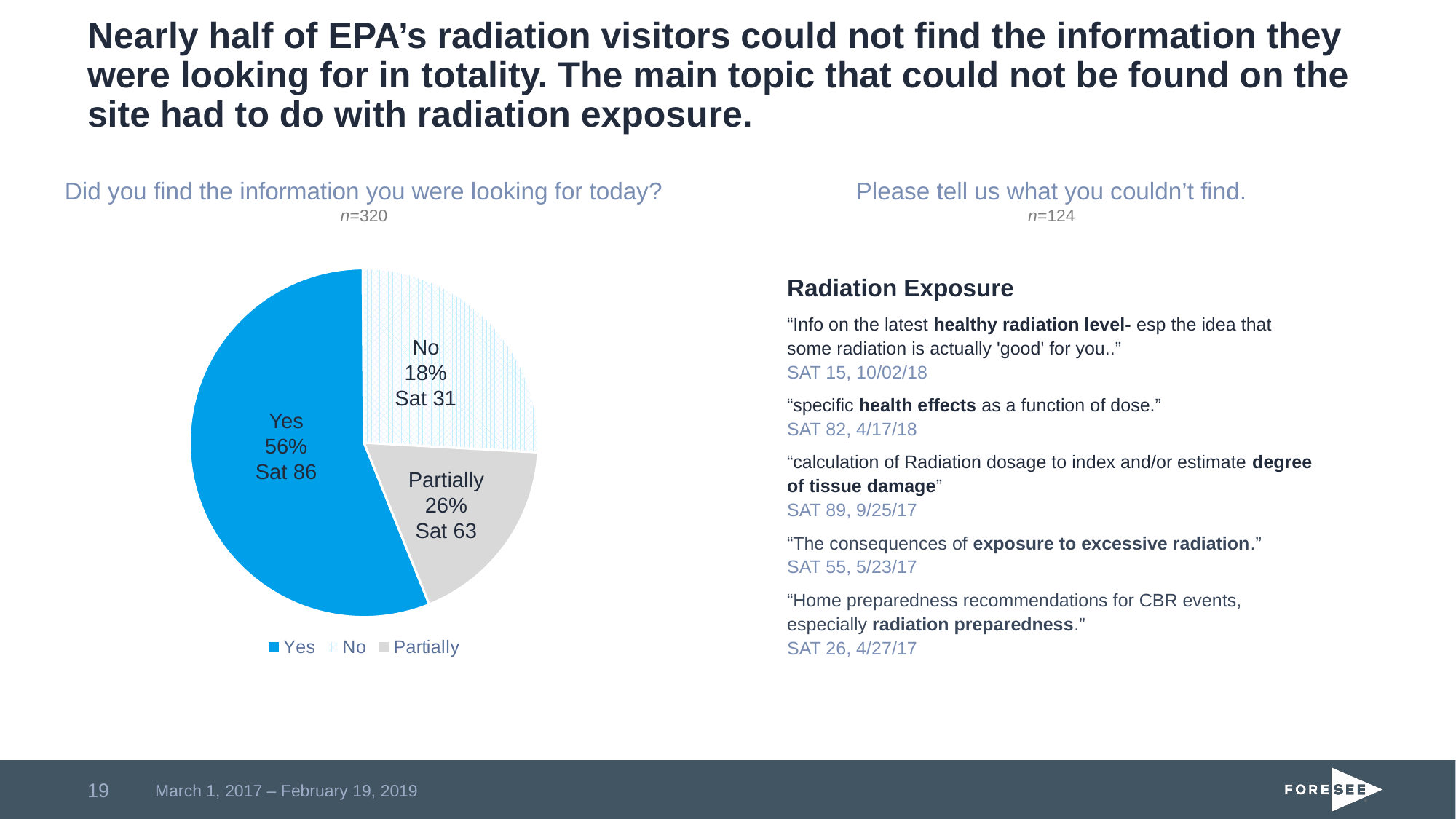
What is the Sat score shown for the "No" slice? Sat 31 What is the sample size (n) shown under the pie chart's question? n=320 What percentage of respondents answered "Yes" to finding the information they were looking for? 56% What kind of chart is shown on the slide? pie chart What percentage of respondents answered "No"? 18% What is the difference in percentage points between the "Yes" and "Partially" slices? 30 What percentage of respondents answered "Partially"? 26% Which response has the largest share of the pie? Yes What is the Sat score shown for the "Yes" slice? Sat 86 How many slices does the pie chart have? 3